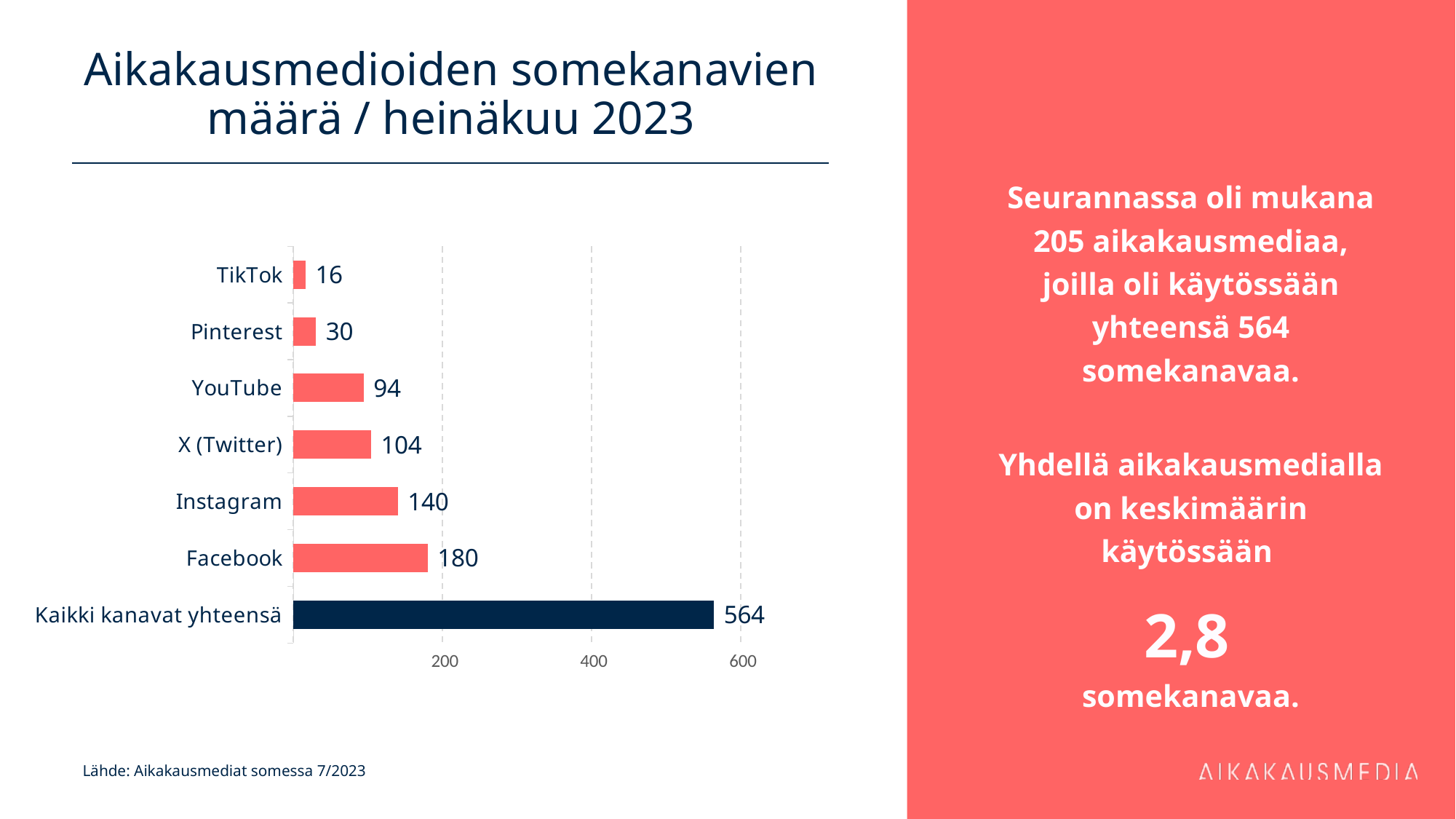
What is the value for X (Twitter)? 104 Which is larger, the value for YouTube or the value for Pinterest? YouTube Which category has the lowest value? TikTok What is the title of the chart? Aikakausmedioiden somekanavien määrä / heinäkuu 2023 Is the value for Instagram greater or less than 200? less How many categories are shown in the chart? 7 What is the value for Kaikki kanavat yhteensä? 564 What is the value for TikTok? 16 What kind of chart is shown on the slide? Bar chart What is the value for Facebook? 180 Which individual channel (excluding the total bar) has the highest value? Facebook What is the difference between the values for Facebook and Instagram? 40